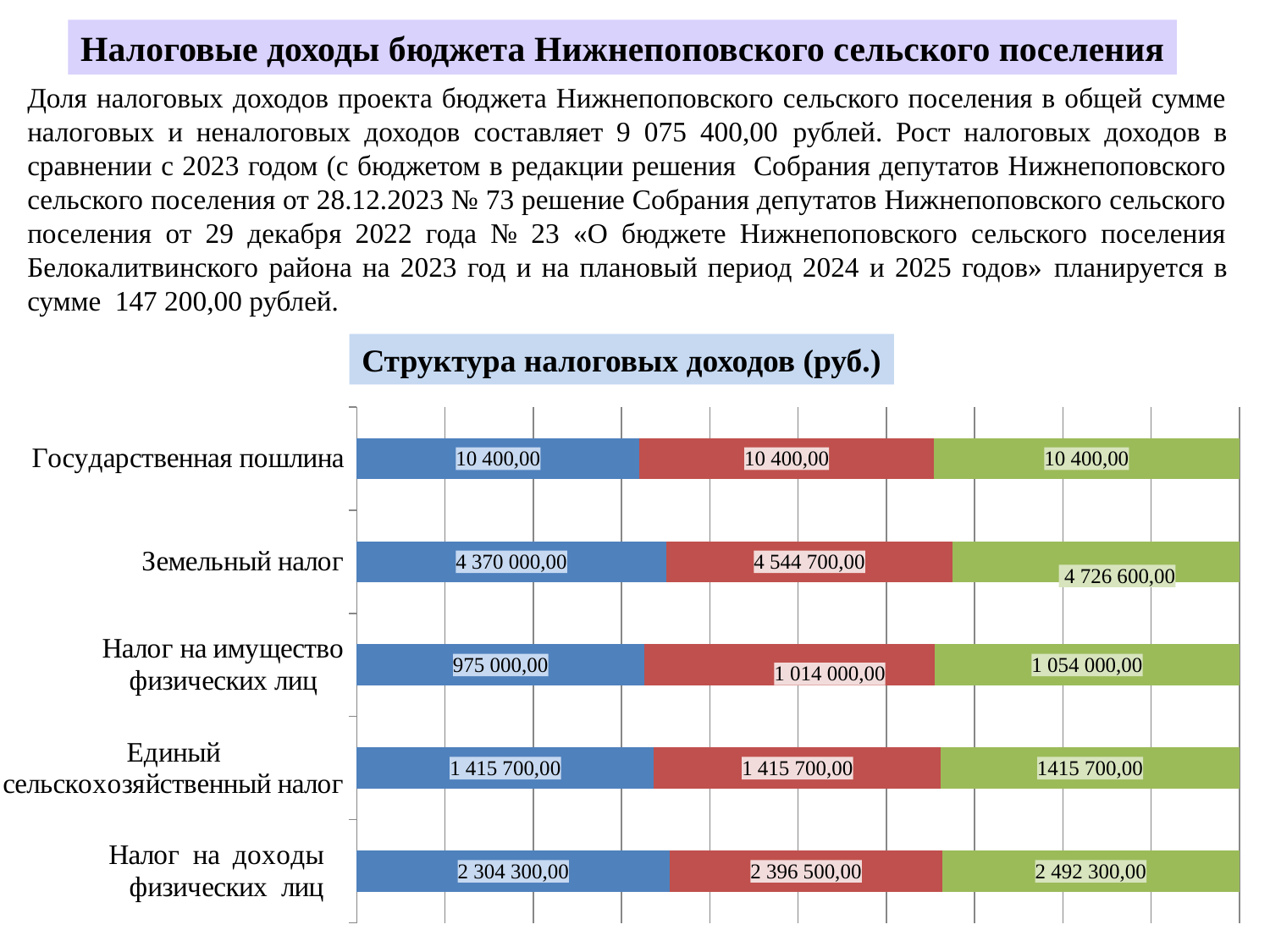
What kind of chart is shown on the slide? Stacked bar chart What is the value of the middle (red) segment for Налог на имущество физических лиц? 1 014 000,00 What is the difference between the green and blue segment values for Земельный налог? 356 600,00 What is the value of the first (blue) segment for Земельный налог? 4 370 000,00 What is the value of the last (green) segment for Налог на доходы физических лиц? 2 492 300,00 Which category has the highest value in the blue segment? Земельный налог What is the difference between the green and blue segment values for Налог на доходы физических лиц? 188 000,00 Which is larger: the blue segment for Земельный налог or the blue segment for Налог на доходы физических лиц? Земельный налог Which category has the lowest value in the blue segment? Государственная пошлина How many tax categories are shown on the chart? 5 What is the title of the chart? Структура налоговых доходов (руб.) What is the total of the three segments for Государственная пошлина? 31 200,00